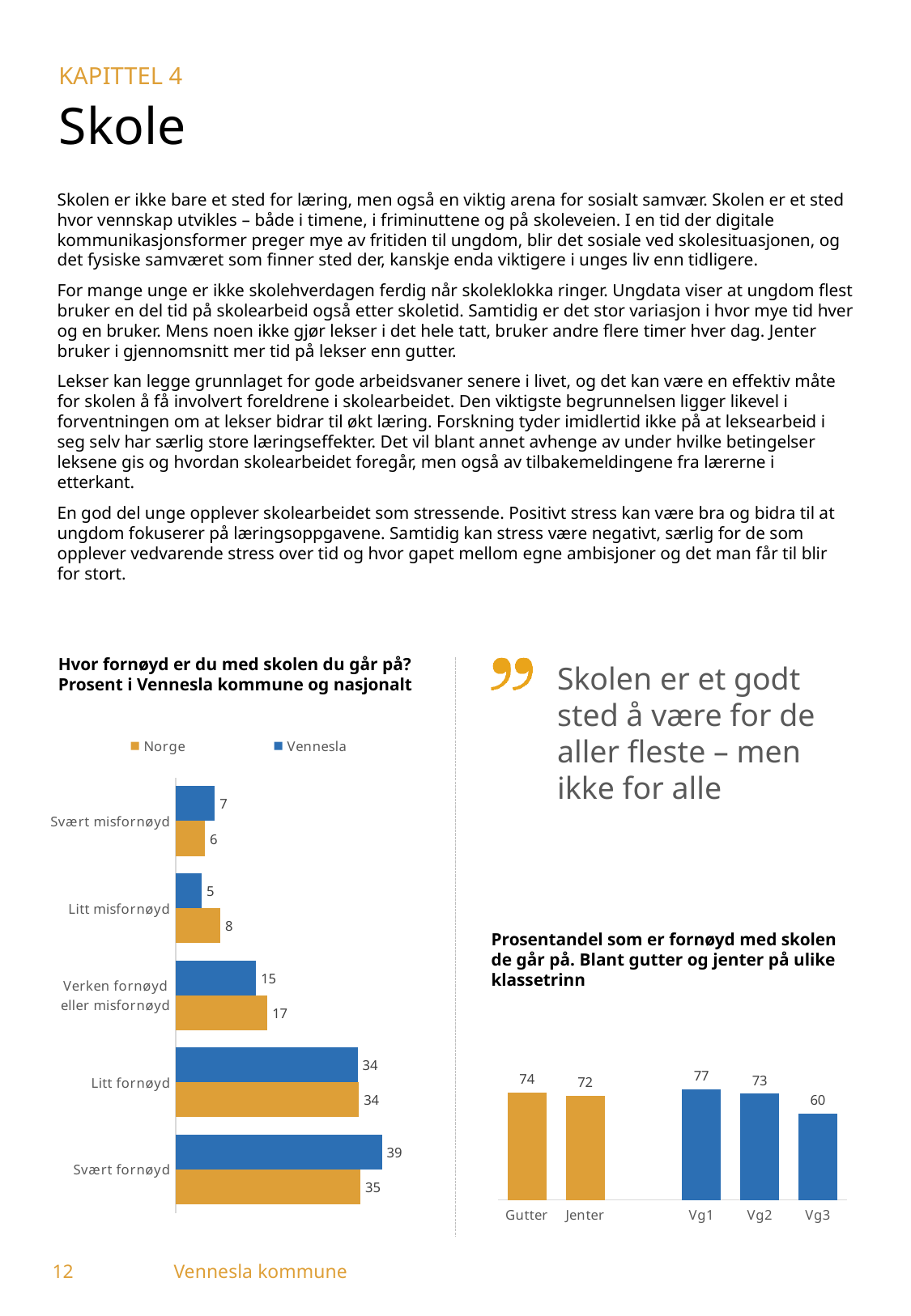
In the chart 'Hvor fornøyd er du med skolen du går på?', which category has the lowest value for Norge? Svært misfornøyd How many categories are shown in the chart 'Hvor fornøyd er du med skolen du går på?'? 5 In the chart 'Hvor fornøyd er du med skolen du går på?', which category has the highest value for Vennesla? Svært fornøyd In the chart 'Hvor fornøyd er du med skolen du går på?', what is the value for Vennesla in the category 'Svært fornøyd'? 39 What kind of chart is 'Hvor fornøyd er du med skolen du går på?'? bar chart In the chart 'Hvor fornøyd er du med skolen du går på?', what is the value for Norge in the category 'Litt misfornøyd'? 8 In the chart 'Prosentandel som er fornøyd med skolen de går på', what is the difference between Gutter and Jenter? 2 How many series does the legend list in the chart 'Hvor fornøyd er du med skolen du går på?'? 2 In the chart 'Prosentandel som er fornøyd med skolen de går på', which category has the highest value? Vg1 In the chart 'Hvor fornøyd er du med skolen du går på?', which is larger in the category 'Verken fornøyd eller misfornøyd', Norge or Vennesla? Norge In the chart 'Hvor fornøyd er du med skolen du går på?', what is the difference between Vennesla and Norge in the category 'Svært fornøyd'? 4 In the chart 'Prosentandel som er fornøyd med skolen de går på', what is the value for Vg3? 60